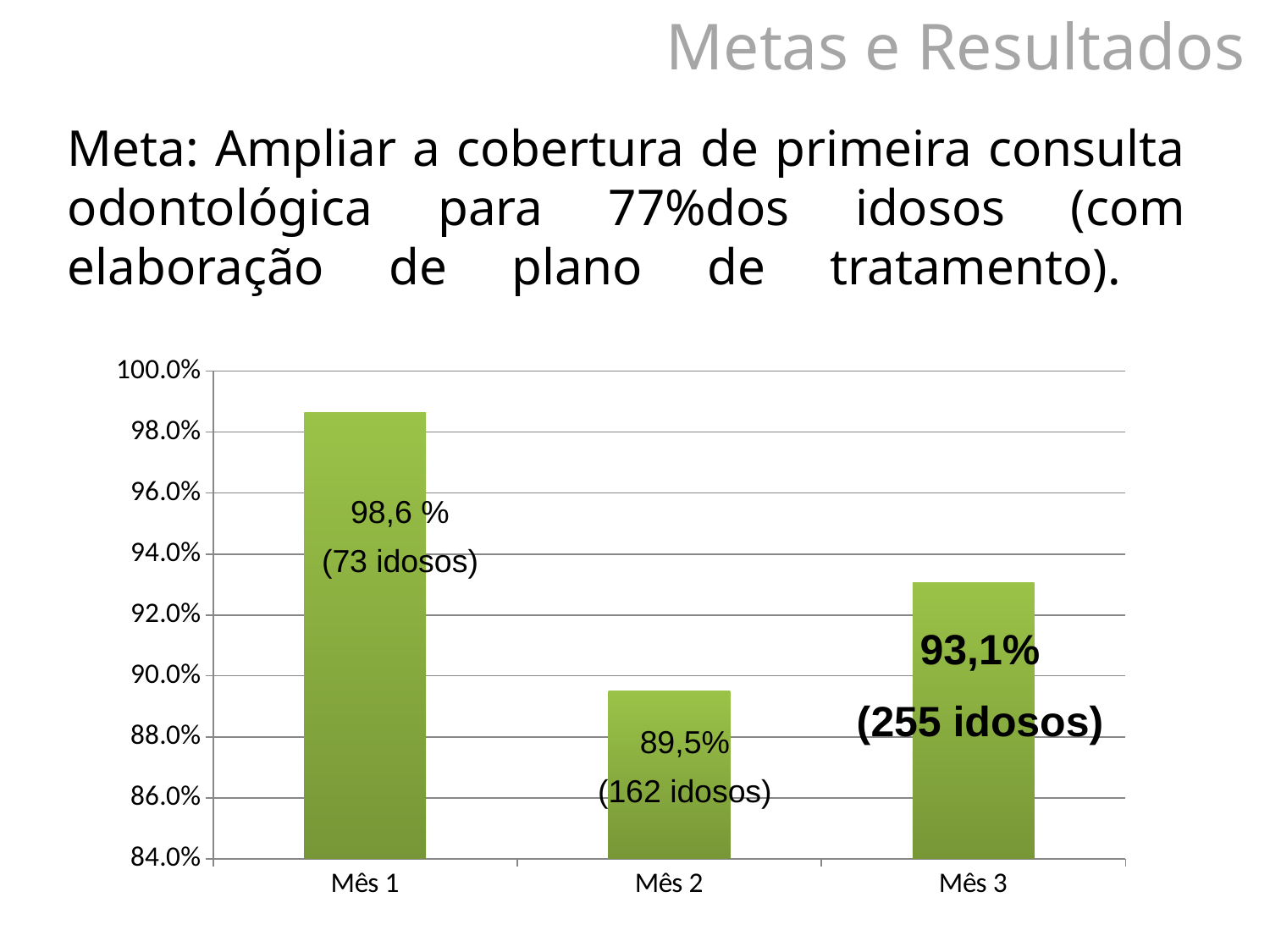
What kind of chart is shown on the slide? bar chart How many months (categories) are shown on the x axis? 3 What percentage is shown for Mês 2? 89,5% Which month has the lowest percentage? Mês 2 What percentage is shown for Mês 1? 98,6 % How many idosos are indicated for Mês 2? 162 idosos What is the difference in percentage points between Mês 1 and Mês 2? 9,1 What percentage is shown for Mês 3? 93,1% How many idosos are indicated for Mês 3? 255 idosos Which month has the highest percentage? Mês 1 Which is larger, the percentage for Mês 3 or for Mês 2? Mês 3 Is the value for Mês 2 greater or less than 90.0%? less